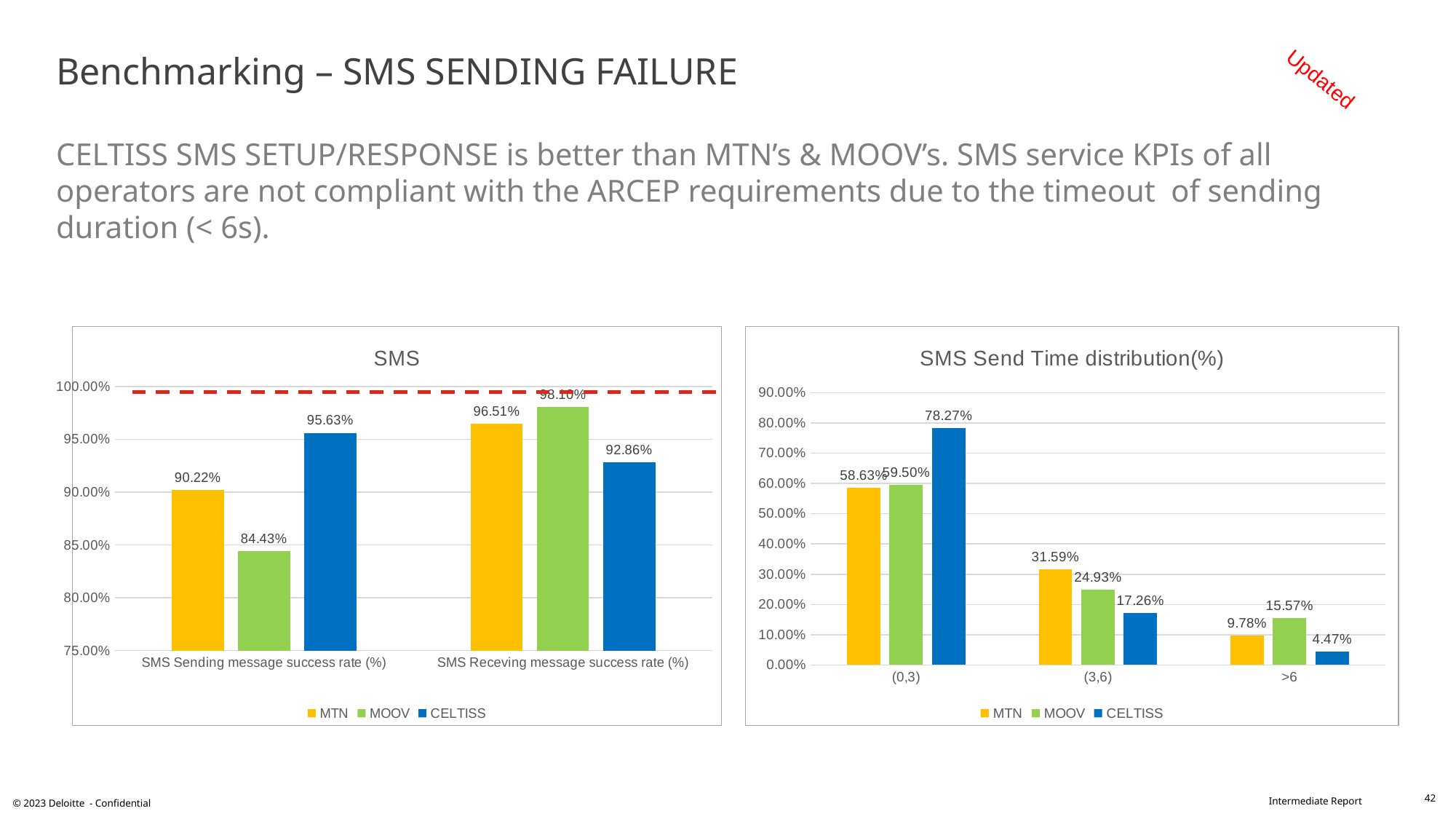
In the "SMS" chart, how many series does the legend list? 3 In the "SMS Send Time distribution(%)" chart, what is the difference between MTN's and CELTISS's values in the >6 category? 5.31% In the "SMS Send Time distribution(%)" chart, what is the value for MOOV in the >6 category? 15.57% What kind of chart is the "SMS Send Time distribution(%)" chart? Bar chart In the "SMS" chart, what is the SMS Sending message success rate for MOOV? 84.43% In the "SMS Send Time distribution(%)" chart, which operator has the highest value in the (3,6) category? MTN In the "SMS Send Time distribution(%)" chart, how many categories are shown on the x axis? 3 In the "SMS Send Time distribution(%)" chart, what is the value for CELTISS in the (0,3) category? 78.27% In the "SMS" chart, what is the SMS Sending message success rate for CELTISS? 95.63% In the "SMS" chart, which operator has the lowest SMS Sending message success rate? MOOV In the "SMS" chart, what is the difference between CELTISS's and MTN's SMS Sending message success rate? 5.41% In the "SMS" chart, which operator has the lowest SMS Receving message success rate? CELTISS